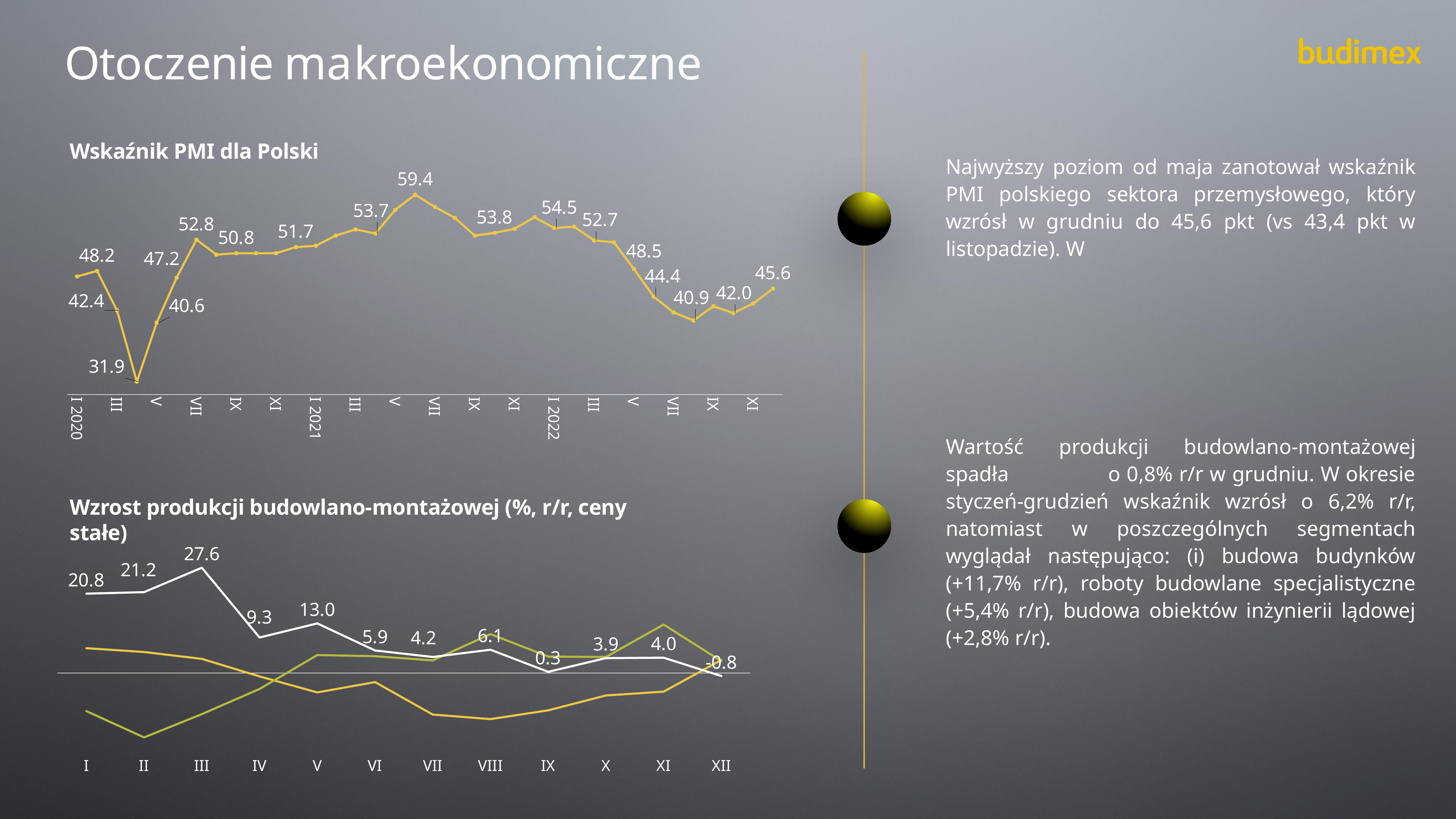
In the 'Wzrost produkcji budowlano-montażowej' chart, which labelled value is larger: IV (9.3) or V (13.0)? V In the 'Wzrost produkcji budowlano-montażowej' chart, what is the labelled value for XII? -0.8 In the 'Wzrost produkcji budowlano-montażowej' chart, which month has the highest labelled value? III What kind of chart is the 'Wskaźnik PMI dla Polski' chart? line chart In the 'Wskaźnik PMI dla Polski' chart, what is the value of the last point on the line? 45.6 How many months are shown on the x axis of the 'Wzrost produkcji budowlano-montażowej' chart? 12 In the 'Wskaźnik PMI dla Polski' chart, what is the difference between the highest labelled value (59.4) and the lowest labelled value (31.9)? 27.5 How many lines are plotted in the 'Wzrost produkcji budowlano-montażowej' chart? 3 In the 'Wzrost produkcji budowlano-montażowej' chart, what is the labelled value for III? 27.6 In the 'Wskaźnik PMI dla Polski' chart, what is the lowest labelled value? 31.9 In the 'Wskaźnik PMI dla Polski' chart, what is the highest labelled value? 59.4